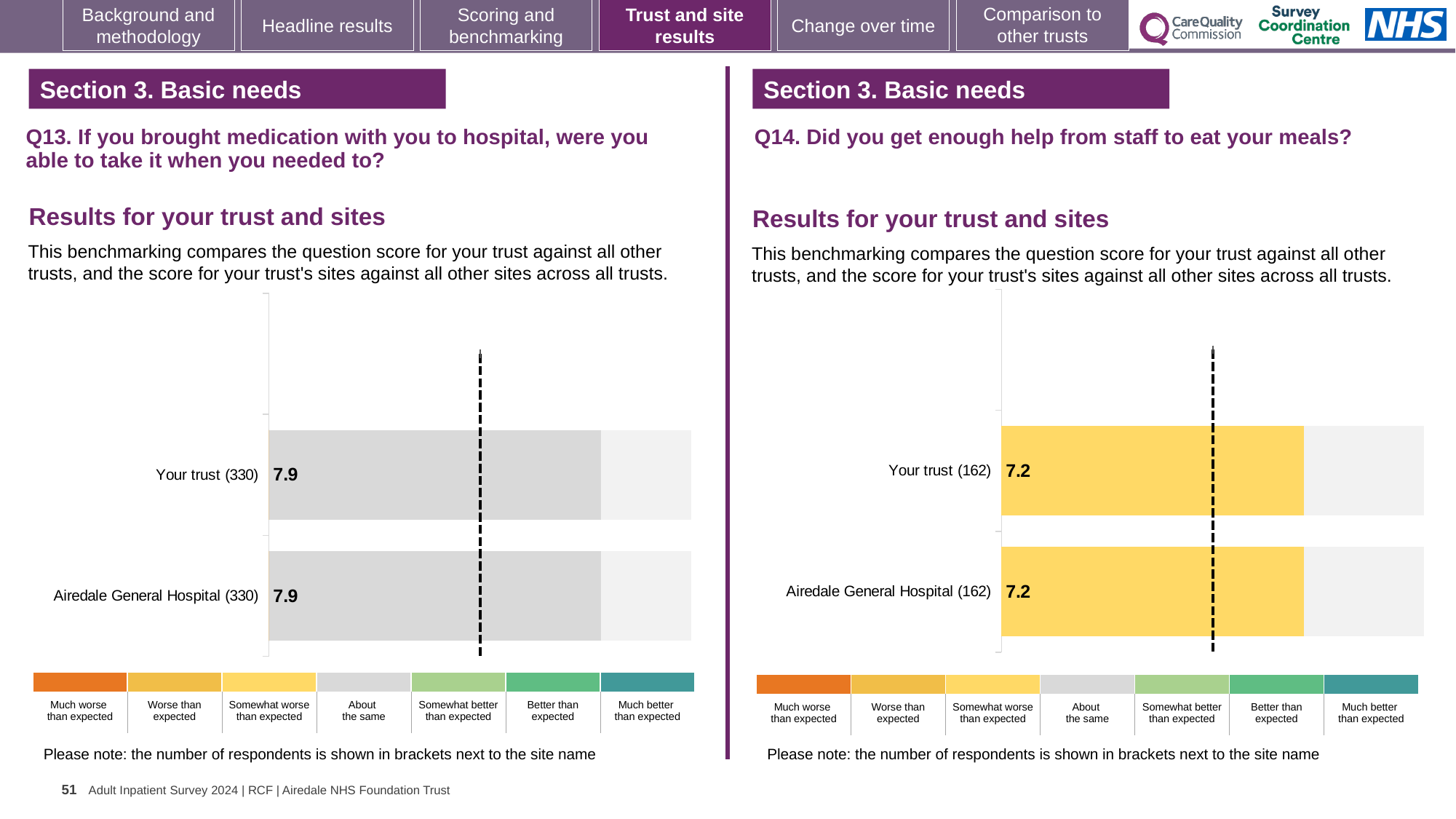
What kind of chart is used on the Q14 chart (right)? Bar chart How many bars are plotted on the Q14 chart (right)? 2 On the Q13 chart (left), what is the score for Your trust (330)? 7.9 How many bars are plotted on the Q13 chart (left)? 2 On the Q14 chart (right), what is the score for Airedale General Hospital (162)? 7.2 On the Q14 chart (right), what is the difference between the score for Your trust and the score for Airedale General Hospital? 0.0 Is the score for Your trust on the Q13 chart (left) larger or smaller than the score for Your trust on the Q14 chart (right)? Larger On the Q13 chart (left), what is the difference between the score for Your trust and the score for Airedale General Hospital? 0.0 On the Q14 chart (right), which benchmark category does the colour of the bars correspond to in the legend? Somewhat worse than expected On the Q13 chart (left), how many respondents are shown in brackets for Airedale General Hospital? 330 On the Q13 chart (left), what is the score for Airedale General Hospital (330)? 7.9 On the Q14 chart (right), what is the score for Your trust (162)? 7.2